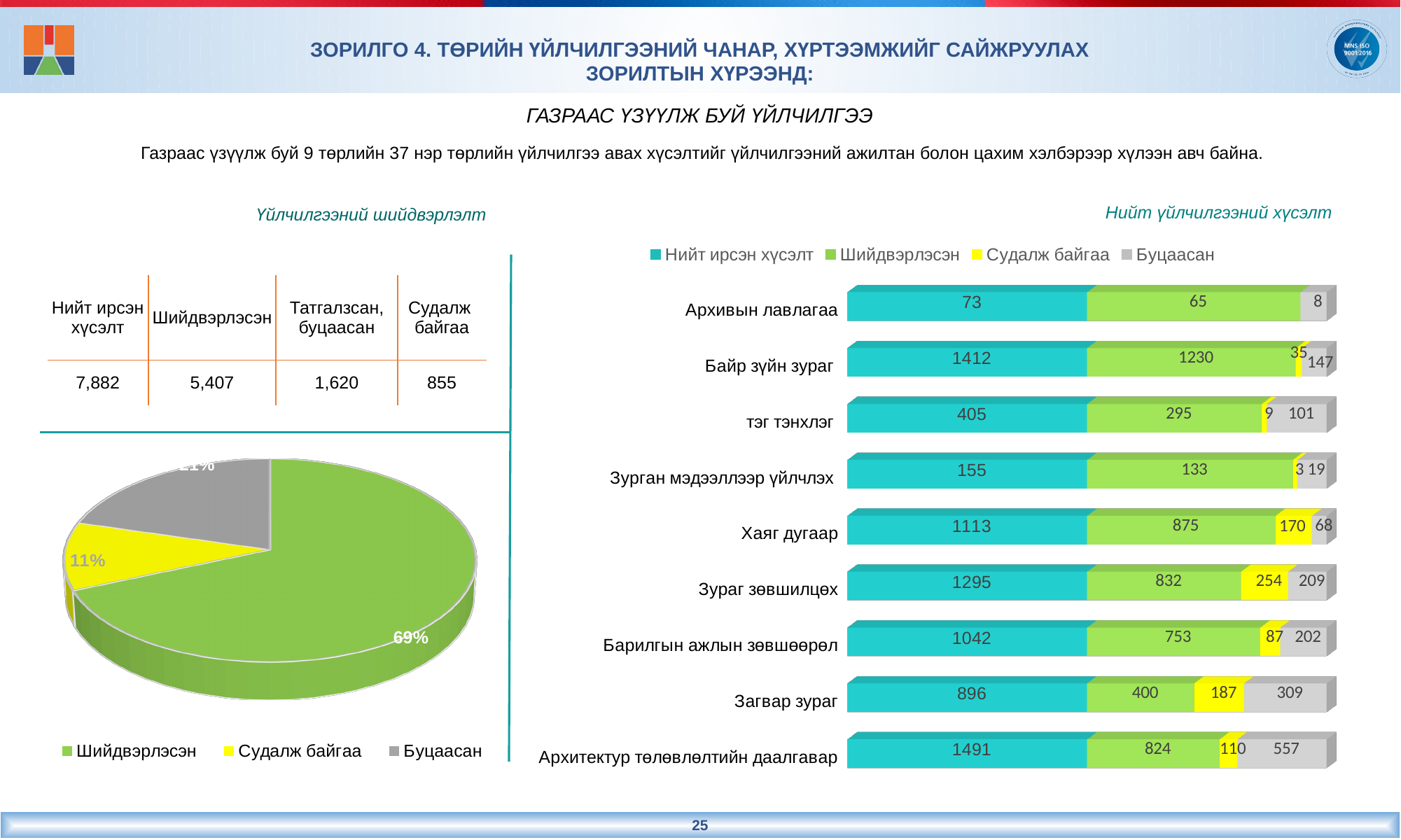
How many categories are shown in the chart titled 'Нийт үйлчилгээний хүсэлт'? 9 In the chart titled 'Нийт үйлчилгээний хүсэлт', what is the 'Шийдвэрлэсэн' value for 'Хаяг дугаар'? 875 In the chart titled 'Нийт үйлчилгээний хүсэлт', which category has the lowest 'Нийт ирсэн хүсэлт' value? Архивын лавлагаа In the chart titled 'Нийт үйлчилгээний хүсэлт', what is the 'Буцаасан' value for 'Архитектур төлөвлөлтийн даалгавар'? 557 In the chart titled 'Нийт үйлчилгээний хүсэлт', what is the difference between the 'Нийт ирсэн хүсэлт' values for 'Архитектур төлөвлөлтийн даалгавар' and 'Байр зүйн зураг'? 79 In the chart titled 'Нийт үйлчилгээний хүсэлт', which category has the highest 'Нийт ирсэн хүсэлт' value? Архитектур төлөвлөлтийн даалгавар In the chart titled 'Нийт үйлчилгээний хүсэлт', for 'Загвар зураг', which is larger: the 'Судалж байгаа' value or the 'Буцаасан' value? Буцаасан In the pie chart titled 'Үйлчилгээний шийдвэрлэлт', what share does 'Шийдвэрлэсэн' have? 69% In the chart titled 'Нийт үйлчилгээний хүсэлт', what is the 'Судалж байгаа' value for 'Зураг зөвшилцөх'? 254 What kind of chart is the chart titled 'Үйлчилгээний шийдвэрлэлт' on the left of the slide? Pie chart In the chart titled 'Нийт үйлчилгээний хүсэлт', what is the 'Нийт ирсэн хүсэлт' value for 'Байр зүйн зураг'? 1412 How many series does the legend of the chart titled 'Нийт үйлчилгээний хүсэлт' list? 4